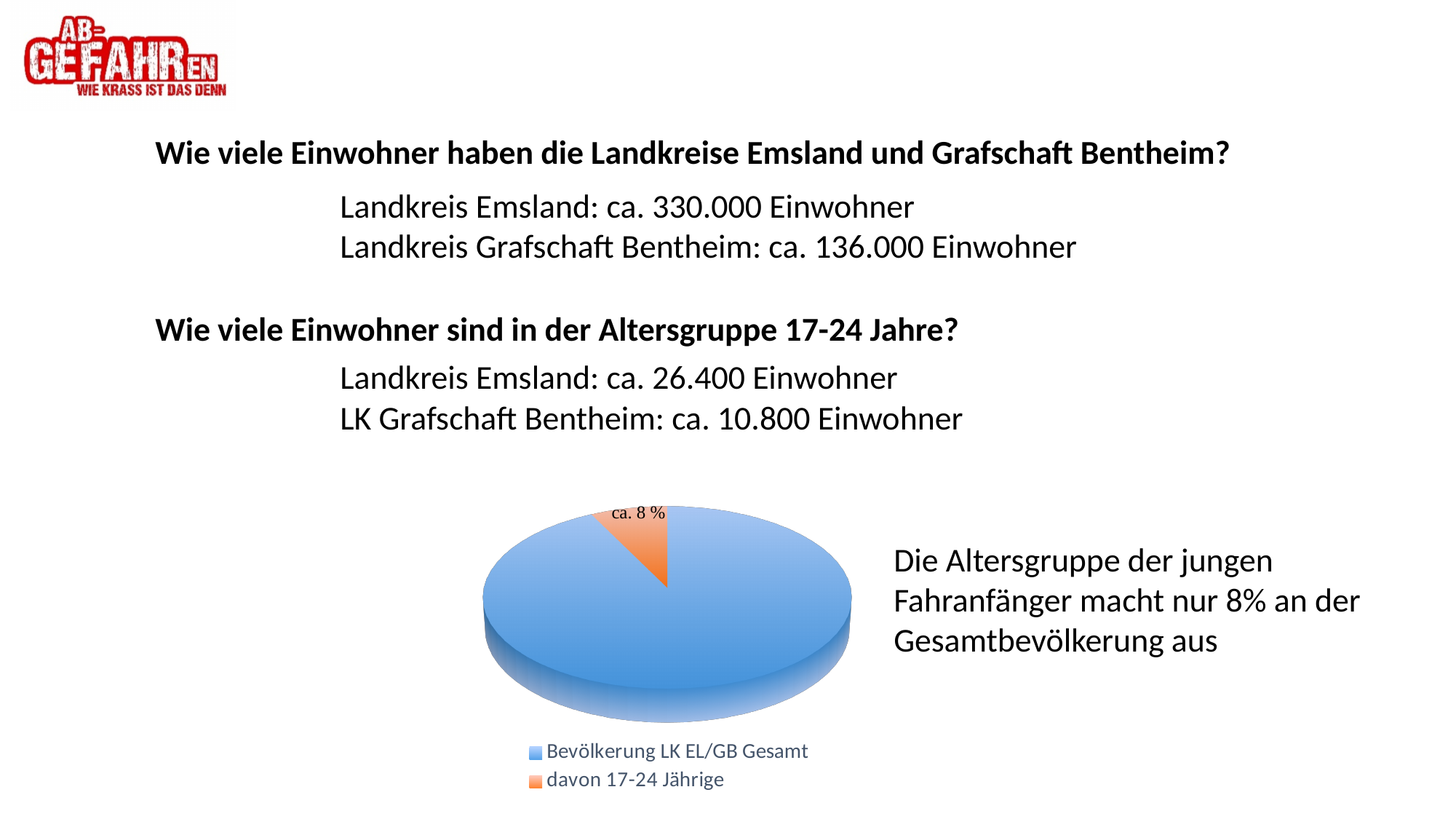
What kind of chart is shown on the slide? pie chart How many entries does the legend of the pie chart list? 2 What colour is the 'davon 17-24 Jährige' slice in the pie chart? orange How many slices does the pie chart have? 2 Which slice of the pie chart is the smallest? davon 17-24 Jährige Which slice is larger in the pie chart: 'Bevölkerung LK EL/GB Gesamt' or 'davon 17-24 Jährige'? Bevölkerung LK EL/GB Gesamt Which slice of the pie chart is the largest? Bevölkerung LK EL/GB Gesamt What data label is printed on the 'davon 17-24 Jährige' slice of the pie chart? ca. 8 % What colour is the 'Bevölkerung LK EL/GB Gesamt' slice in the pie chart? blue